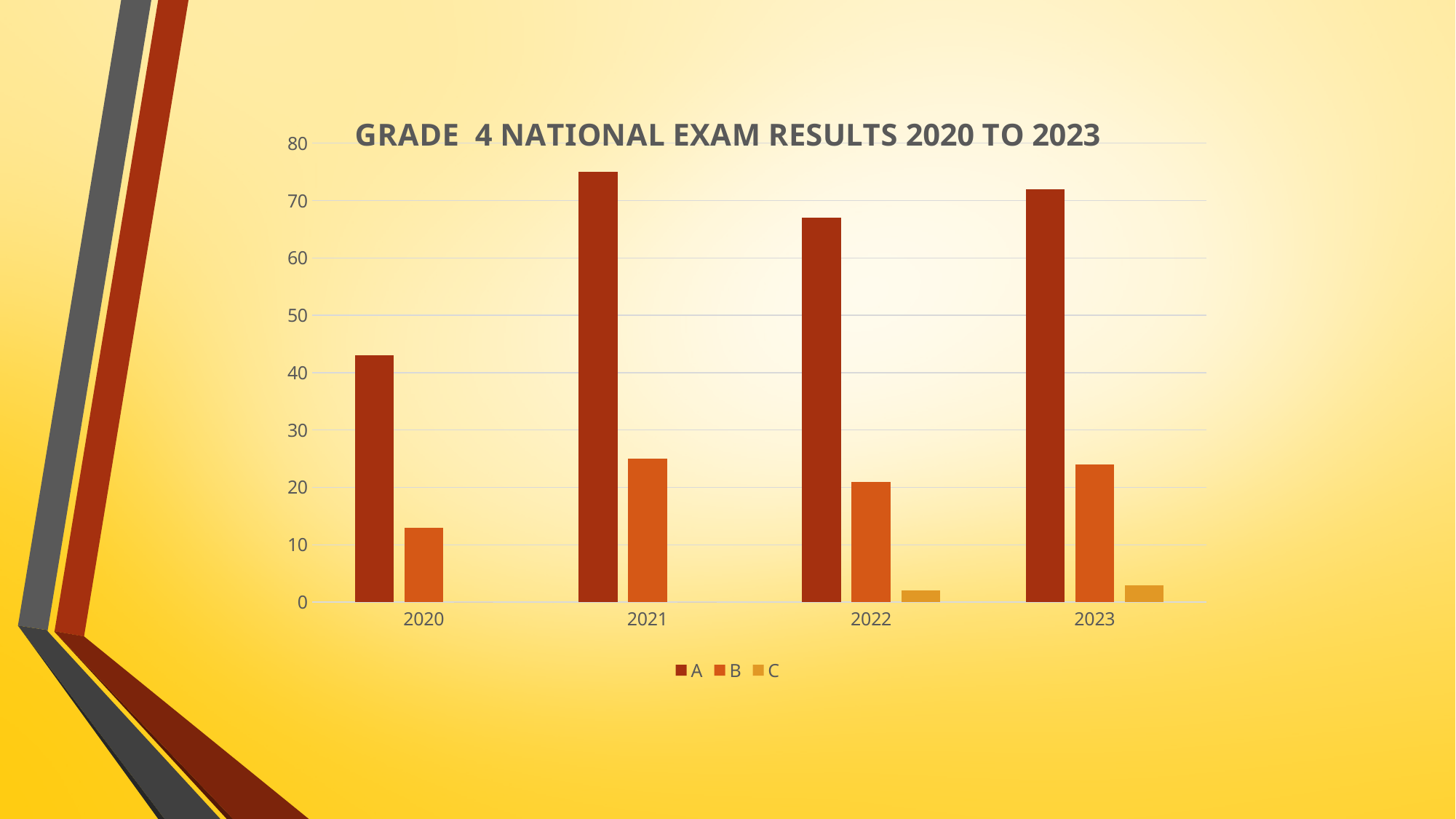
How many years are shown on the x axis? 4 Is the value for series A in 2020 greater or less than 40? greater Is the value for series A in 2021 greater or less than 70? greater How many series does the legend list? 3 Which is larger, the value for series A in 2021 or the value for series A in 2020? 2021 What is the title of the chart? GRADE 4 NATIONAL EXAM RESULTS 2020 TO 2023 Is the value for series B in 2023 greater or less than 20? greater Which series does the legend list first? A In which year is the value for series A lowest? 2020 What kind of chart is shown on the slide? Bar chart In which year is the value for series B lowest? 2020